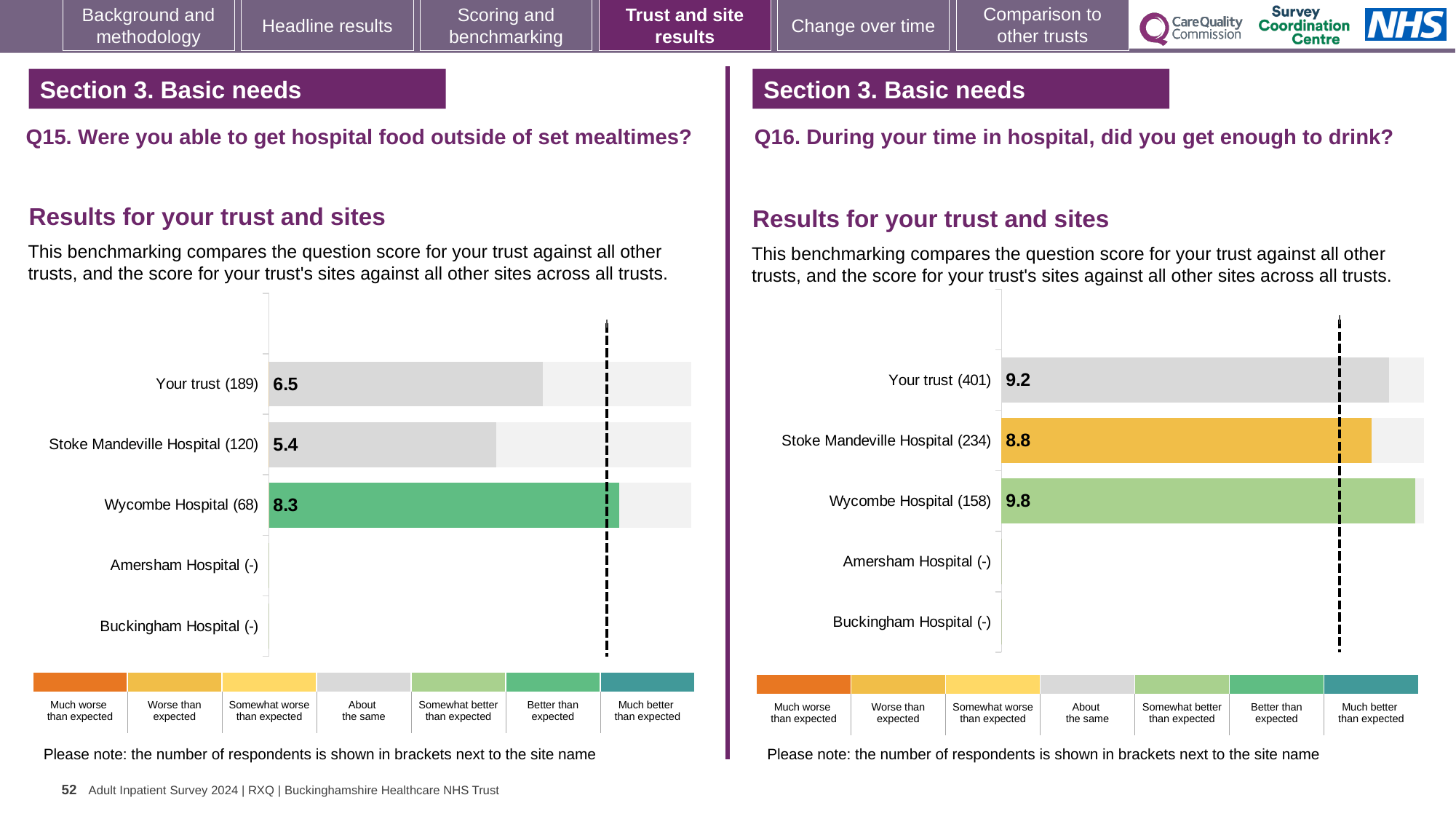
In the Q15 chart (left), which site has the highest score? Wycombe Hospital What type of chart is used on the left for Q15? Bar chart In the Q15 chart (left), what is the score for Your trust? 6.5 In the Q16 chart (right), what is the score for Wycombe Hospital? 9.8 In the Q15 chart (left), how many respondents are shown for Wycombe Hospital? 68 In the Q15 chart (left), what is the score for Stoke Mandeville Hospital? 5.4 In the Q16 chart (right), how many bars have a score plotted? 3 In the Q16 chart (right), which site has the lowest score among those with a score shown? Stoke Mandeville Hospital In the Q16 chart (right), what is the difference between the scores for Your trust and Stoke Mandeville Hospital? 0.4 In the Q16 chart (right), what is the score for Stoke Mandeville Hospital? 8.8 Which is larger: the Q15 score for Your trust or the Q16 score for Your trust? Q16 (9.2) In the Q15 chart (left), what is the difference between the scores for Wycombe Hospital and Stoke Mandeville Hospital? 2.9